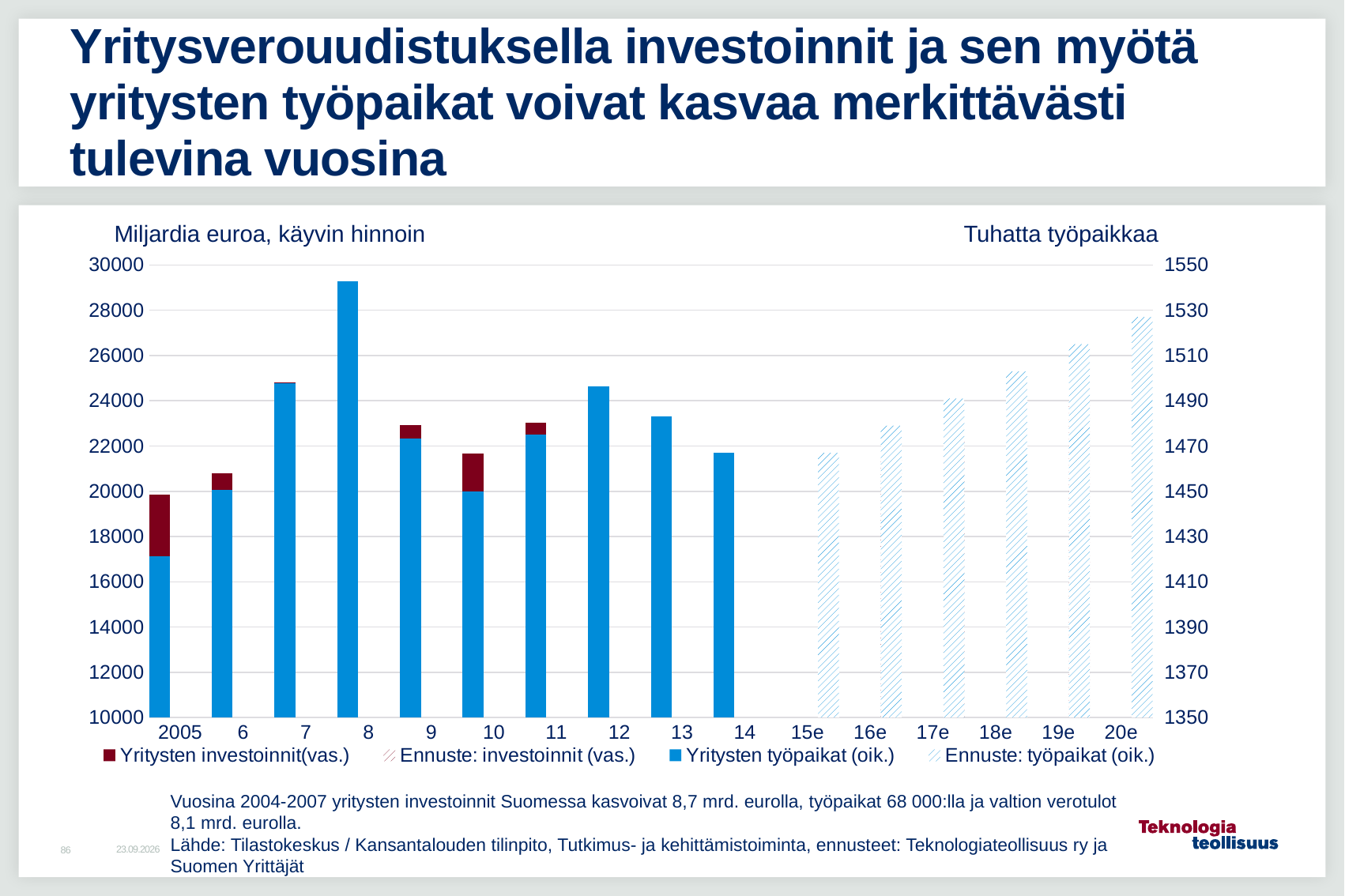
Which year has the highest value for Yritysten työpaikat (oik.)? 2008 Is the value for Yritysten työpaikat (oik.) in 2008 greater or less than 1530? greater Is the value for Yritysten työpaikat (oik.) in 2005 greater or less than 1430? less Which is larger for Yritysten työpaikat (oik.): 2012 or 2013? 2012 How many series does the legend list? 4 What is the title of the right axis? Tuhatta työpaikkaa How many categories are shown on the x axis? 16 Is the value for Ennuste: työpaikat (oik.) in 20e greater or less than 1510? greater Do the values for Ennuste: työpaikat (oik.) rise or fall from 15e to 20e? rise Which year has the lowest value for Yritysten työpaikat (oik.)? 2005 What is the title of the left axis? Miljardia euroa, käyvin hinnoin What kind of chart is shown on the slide? bar chart